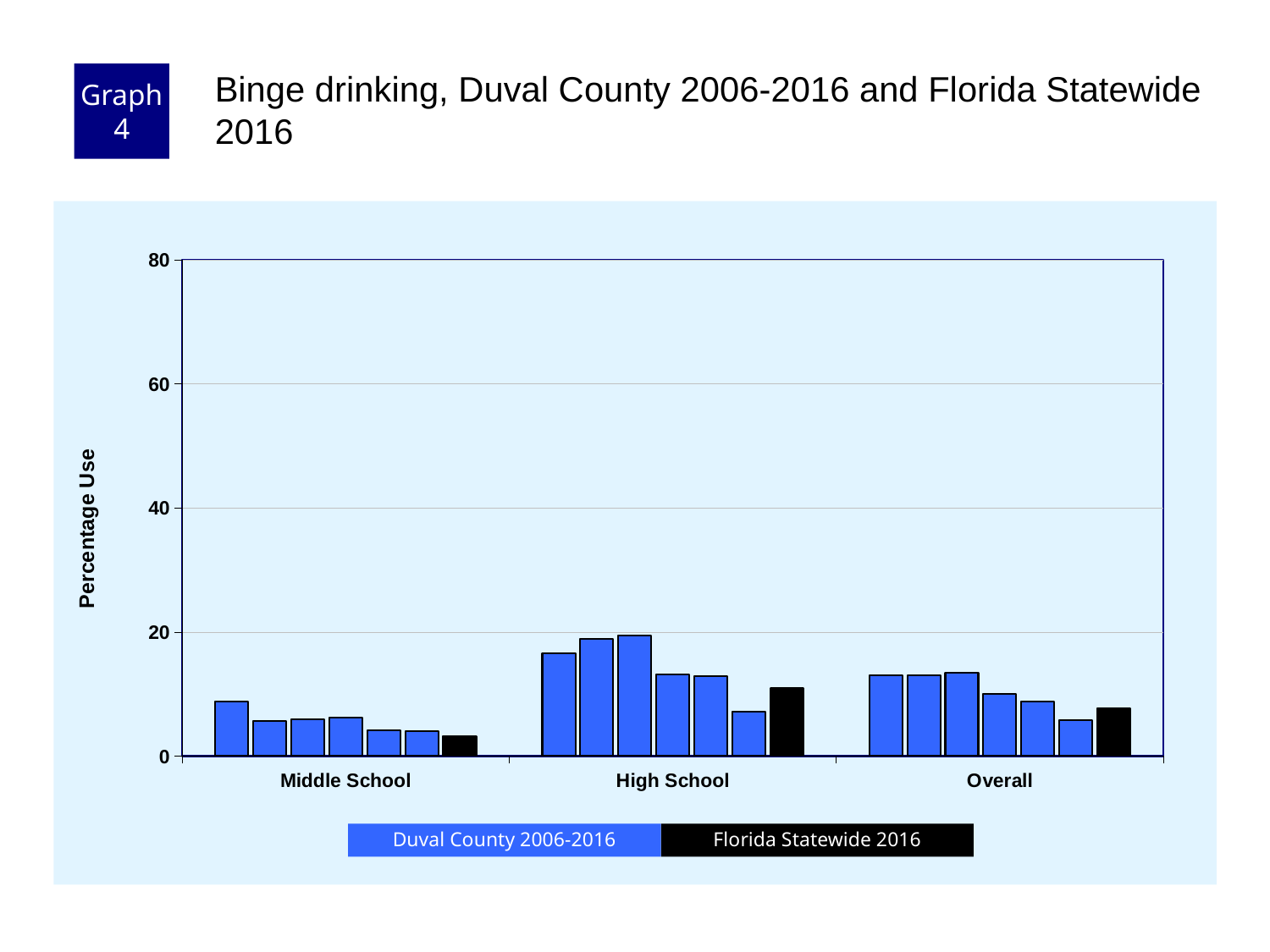
Is the highest Duval County bar for High School greater or less than 20? less How many categories are shown on the x axis of the chart? 3 Which category has the lowest bars in the chart? Middle School Is the Florida Statewide 2016 value for High School greater or less than 20? less What kind of chart is shown on the slide? bar chart Which is larger, the Florida Statewide 2016 bar for High School or the Florida Statewide 2016 bar for Middle School? High School How many series does the chart legend list? 2 Do the Duval County 2006-2016 bars for Overall generally rise or fall from left to right? fall What is the label on the y axis of the chart? Percentage Use Is the Florida Statewide 2016 value for Middle School greater or less than 20? less Which colour represents Florida Statewide 2016 in the chart legend? black Which category has the tallest bars in the chart? High School